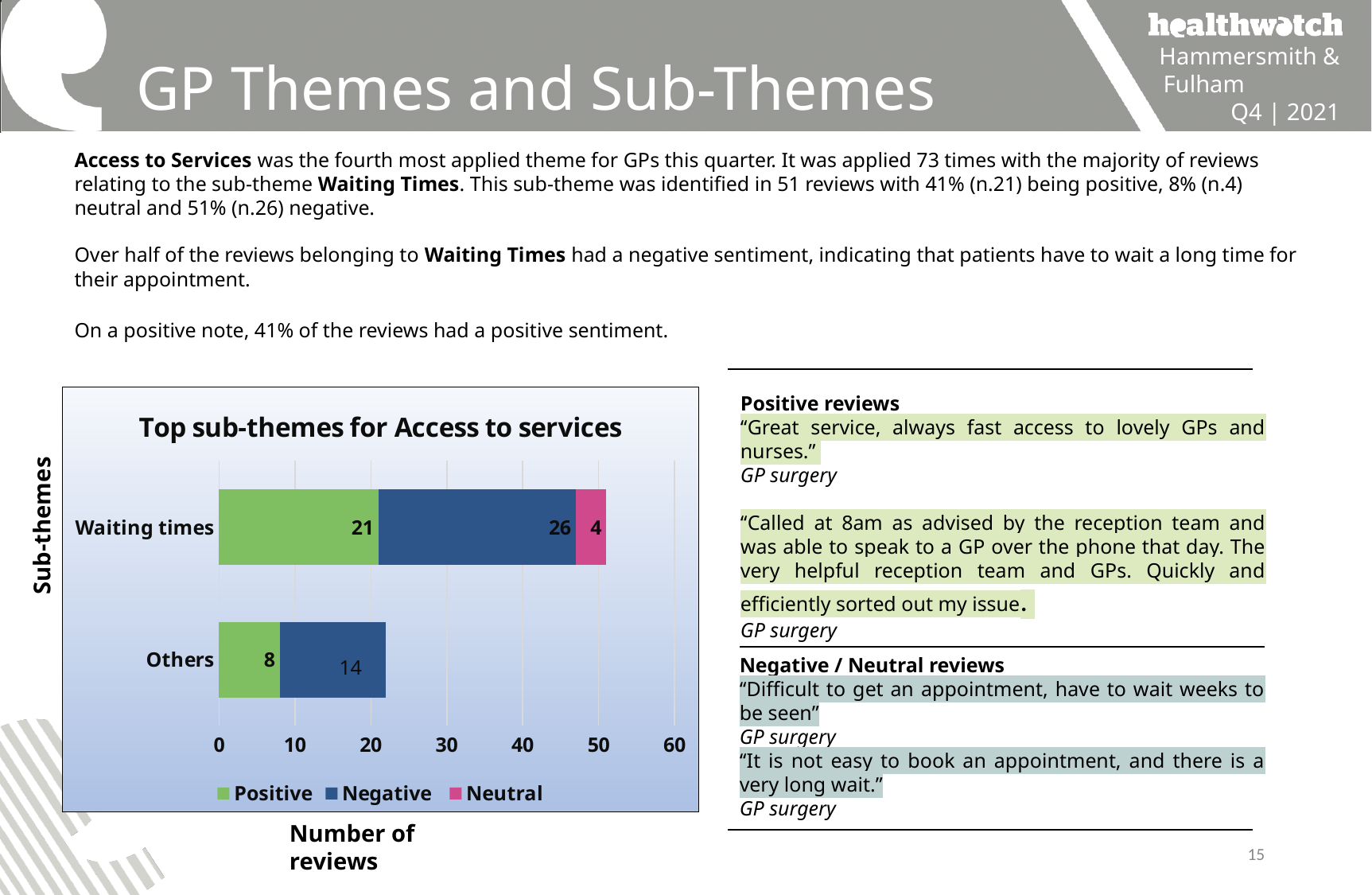
How many series does the chart legend list? 3 What is the difference between the Negative and Positive values for Waiting times? 5 How many sub-theme categories are plotted in the chart? 2 What is the Positive value for Waiting times? 21 What is the total number of reviews in the Waiting times bar? 51 What is the Negative value for Others? 14 Which sub-theme has the higher Negative value, Waiting times or Others? Waiting times What is the Neutral value for Waiting times? 4 What type of chart is shown on the slide? Stacked bar chart What is the title of the chart? Top sub-themes for Access to services What is the Negative value for Waiting times? 26 What is the Positive value for Others? 8